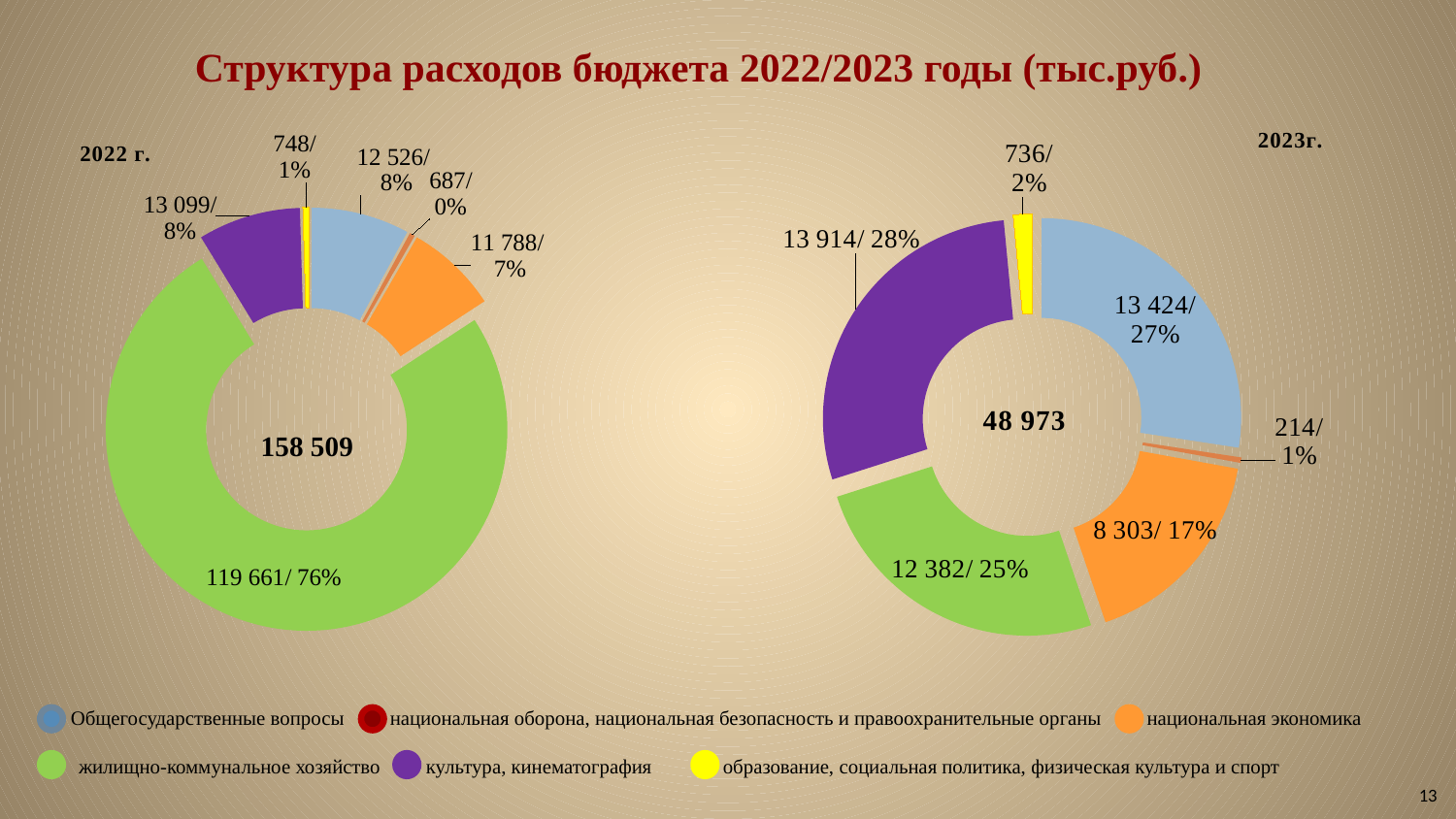
In the 2022 chart, what share of the total does жилищно-коммунальное хозяйство take? 76% In the 2022 chart, what is the value for жилищно-коммунальное хозяйство? 119 661 In the 2022 chart, which is larger: Общегосударственные вопросы or культура, кинематография? культура, кинематография What kind of chart is used on this slide for the 2022 and 2023 budget structure? doughnut chart What total is shown in the centre of the 2022 chart? 158 509 In the 2023 chart, what is the smallest value shown? 214 In the 2023 chart, what share does Общегосударственные вопросы take? 27% In the 2023 chart, what is the value for культура, кинематография? 13 914 How much larger is the value for национальная экономика in 2022 (11 788) than in 2023 (8 303)? 3 485 What total is shown in the centre of the 2023 chart? 48 973 In the 2023 chart, which category has the largest value? культура, кинематография How many categories does the legend list? 6